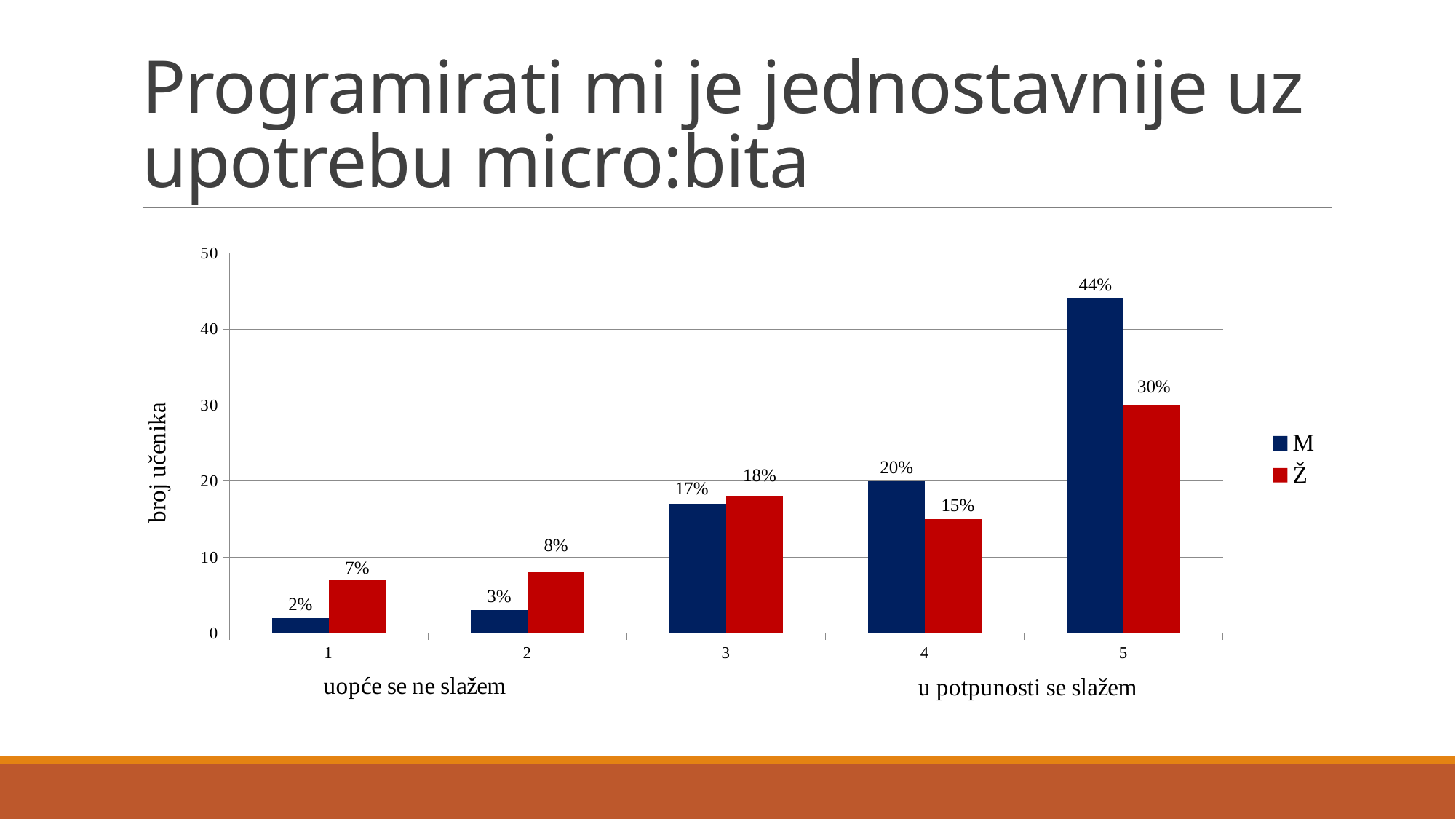
What is the value for M at category 1? 2% What is the value for Ž at category 4? 15% What is the value for Ž at category 3? 18% Which category has the highest value for the M series? 5 How many series does the legend list? 2 Which category has the lowest value for the Ž series? 1 What is the label of the vertical axis? broj učenika What is the difference between the M and Ž values at category 5? 14% What is the value for M at category 5? 44% What kind of chart is shown on the slide? bar chart How many categories are shown on the x axis? 5 At category 2, which series has the larger value, M or Ž? Ž